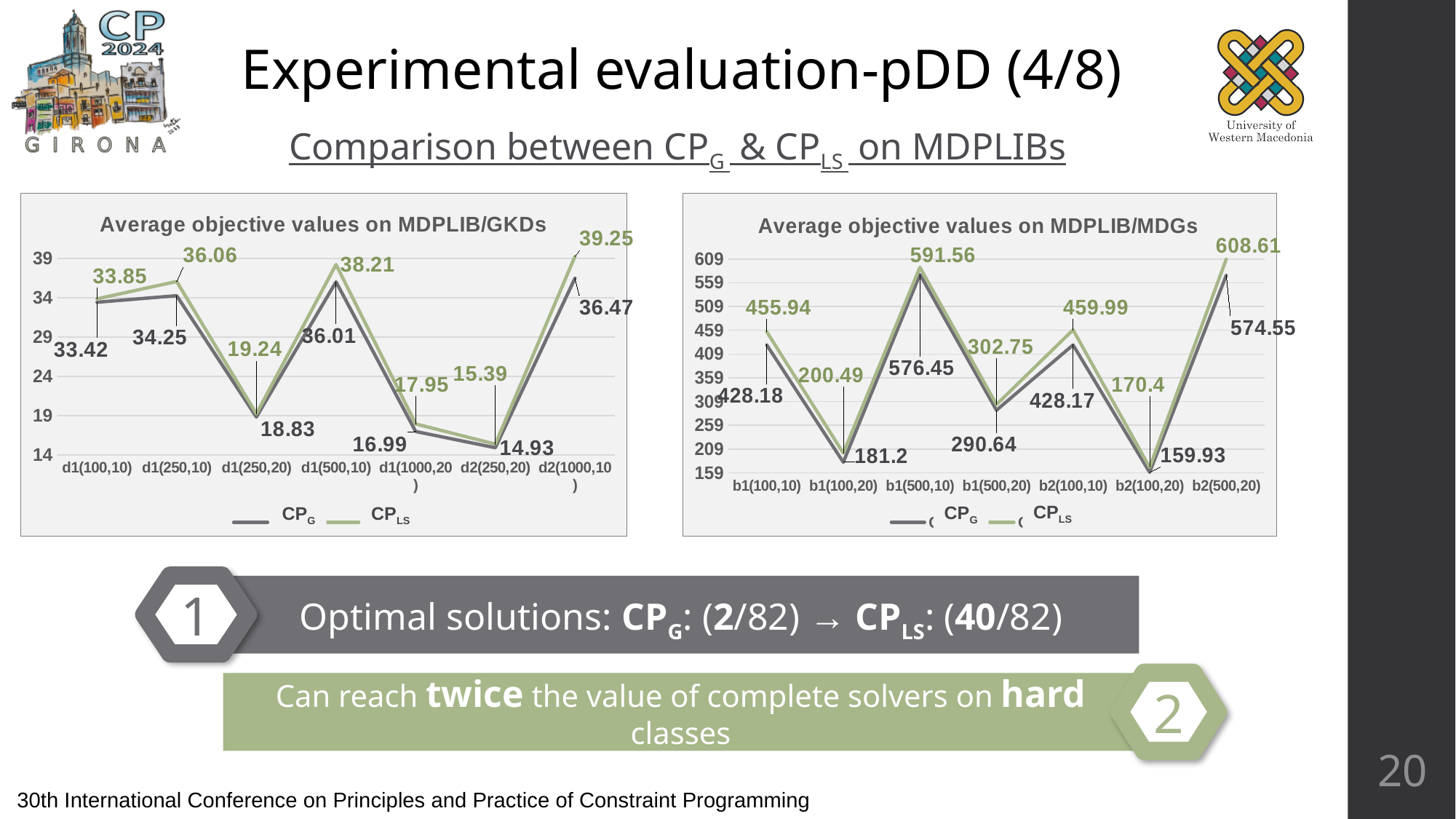
In the 'Average objective values on MDPLIB/MDGs' chart, what is the difference between the CP_LS and CP_G values for b2(500,20)? 34.06 In the 'Average objective values on MDPLIB/MDGs' chart, which is larger for b1(100,20): the CP_G value or the CP_LS value? CP_LS What type of chart is the 'Average objective values on MDPLIB/MDGs' chart? Line chart In the 'Average objective values on MDPLIB/GKDs' chart, which category has the lowest CP_G value? d2(250,20) In the 'Average objective values on MDPLIB/GKDs' chart, what is the CP_G value for d2(250,20)? 14.93 In the 'Average objective values on MDPLIB/MDGs' chart, what is the CP_G value for b2(100,20)? 159.93 In the 'Average objective values on MDPLIB/MDGs' chart, which category has the lowest CP_LS value? b2(100,20) How many categories are shown on the x axis of the 'Average objective values on MDPLIB/GKDs' chart? 7 In the 'Average objective values on MDPLIB/GKDs' chart, what is the difference between the CP_LS and CP_G values for d1(250,10)? 1.81 In the 'Average objective values on MDPLIB/MDGs' chart, what is the CP_LS value for b1(500,10)? 591.56 In the 'Average objective values on MDPLIB/GKDs' chart, which category has the highest CP_LS value? d2(1000,10) In the 'Average objective values on MDPLIB/GKDs' chart, what is the CP_LS value for d1(500,10)? 38.21